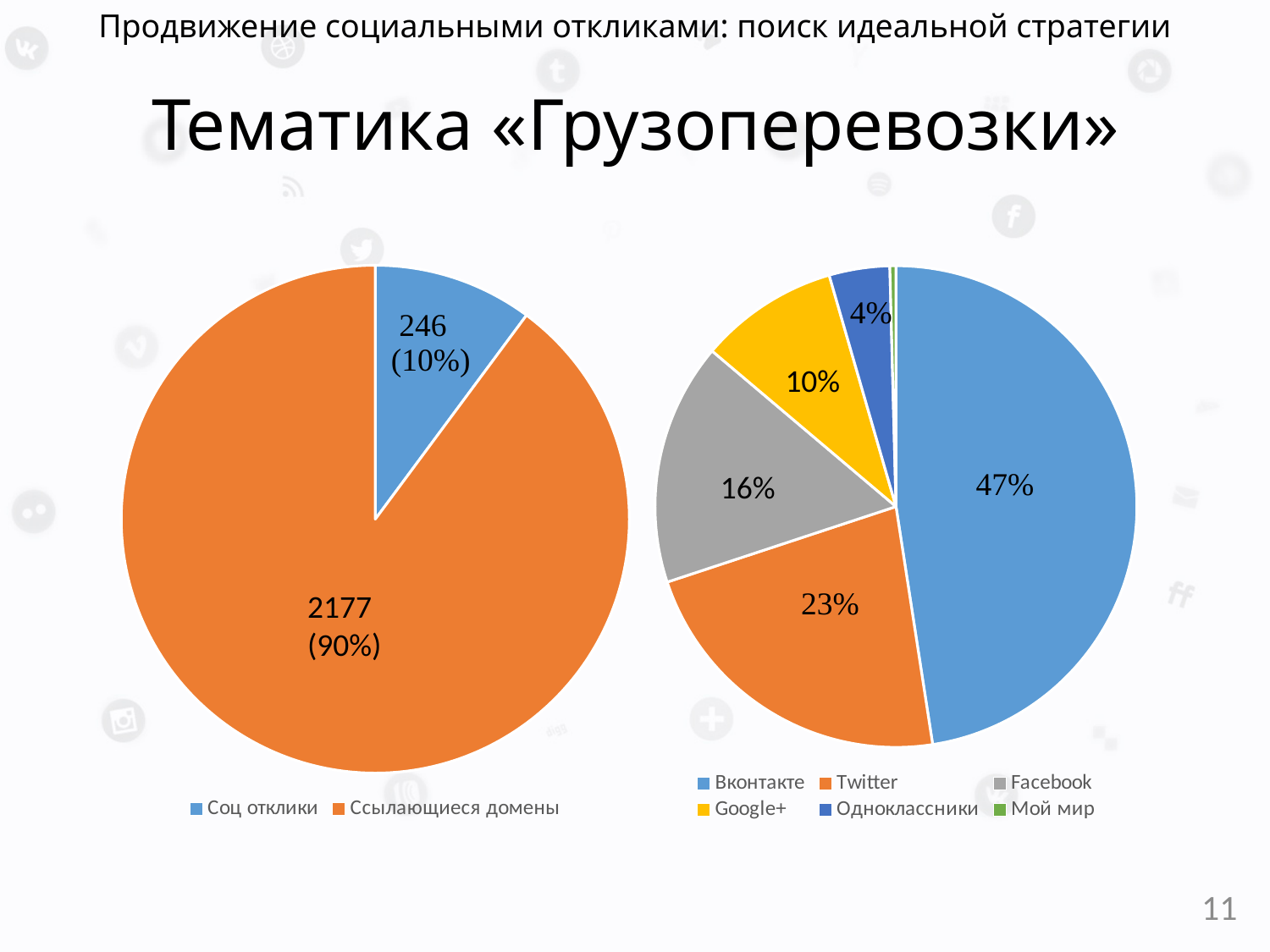
In the left pie chart, what value is shown for Соц отклики? 246 In the right pie chart, what share is shown for Google+? 10% How many categories does the legend of the right pie chart list? 6 In the right pie chart, which category has the largest slice? Вконтакте In the right pie chart, which is larger, Twitter or Facebook? Twitter In the right pie chart, what share is shown for Вконтакте? 47% In the left pie chart, what share of the pie does Ссылающиеся домены take? 90% In the left pie chart, what is the total of the two slices? 2423 In the right pie chart, which category has the smallest slice? Мой мир In the left pie chart, what value is shown for Ссылающиеся домены? 2177 In the left pie chart, what is the difference between the values for Ссылающиеся домены and Соц отклики? 1931